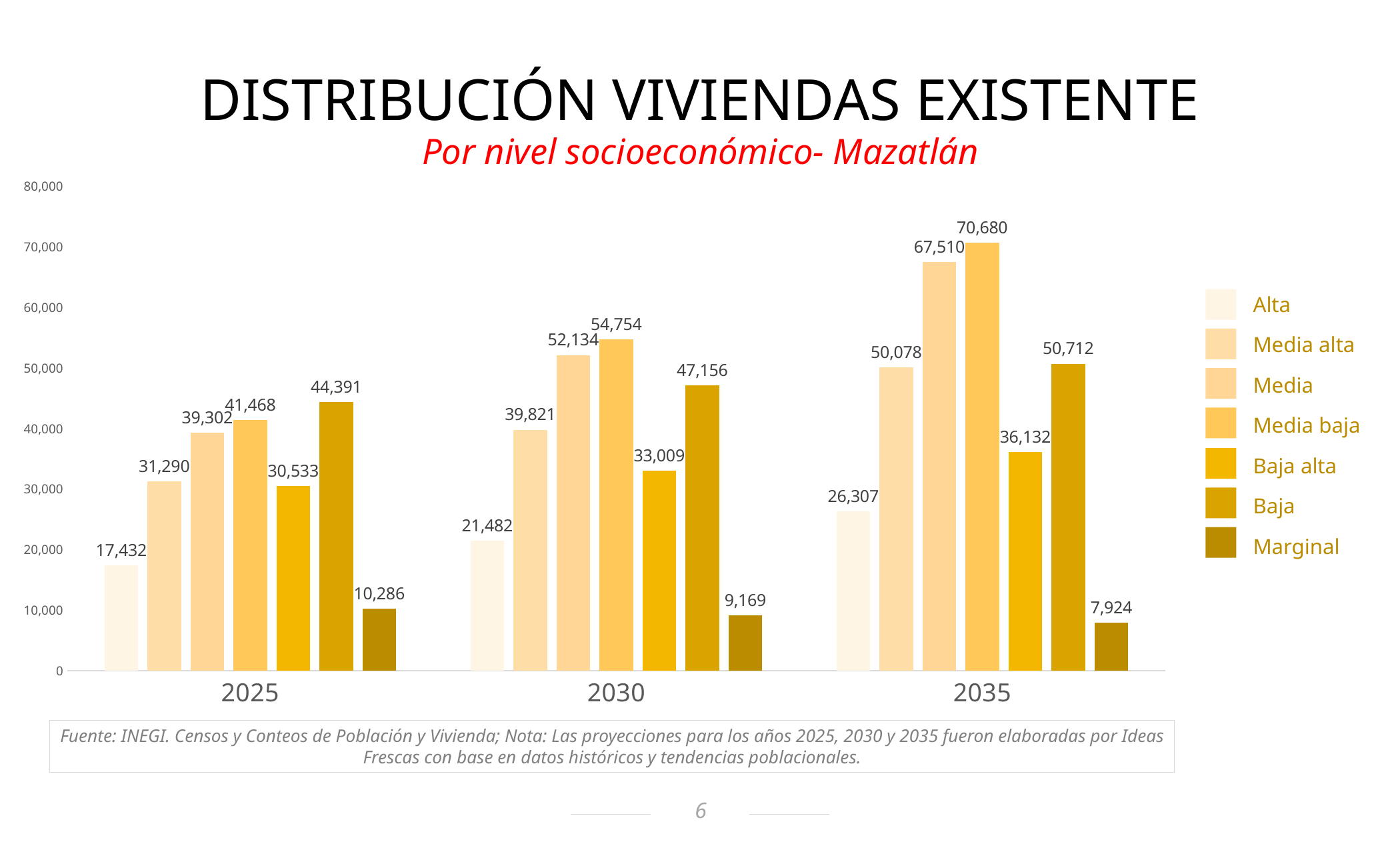
What is the value for Baja alta in 2030? 33,009 What is the value for Media baja in 2035? 70,680 What is the value for Marginal in 2025? 10,286 What is the difference between the Media baja values for 2035 and 2030? 15,926 Which is larger in 2030: Media or Baja? Media Which series has the highest value in 2025? Baja What is the difference between Baja and Baja alta in 2025? 13,858 What kind of chart is shown on the slide? Bar chart How many year categories are shown on the x axis? 3 How many series does the legend list? 7 Do the Marginal values rise or fall from 2025 to 2035? Fall Which series has the lowest value in 2035? Marginal